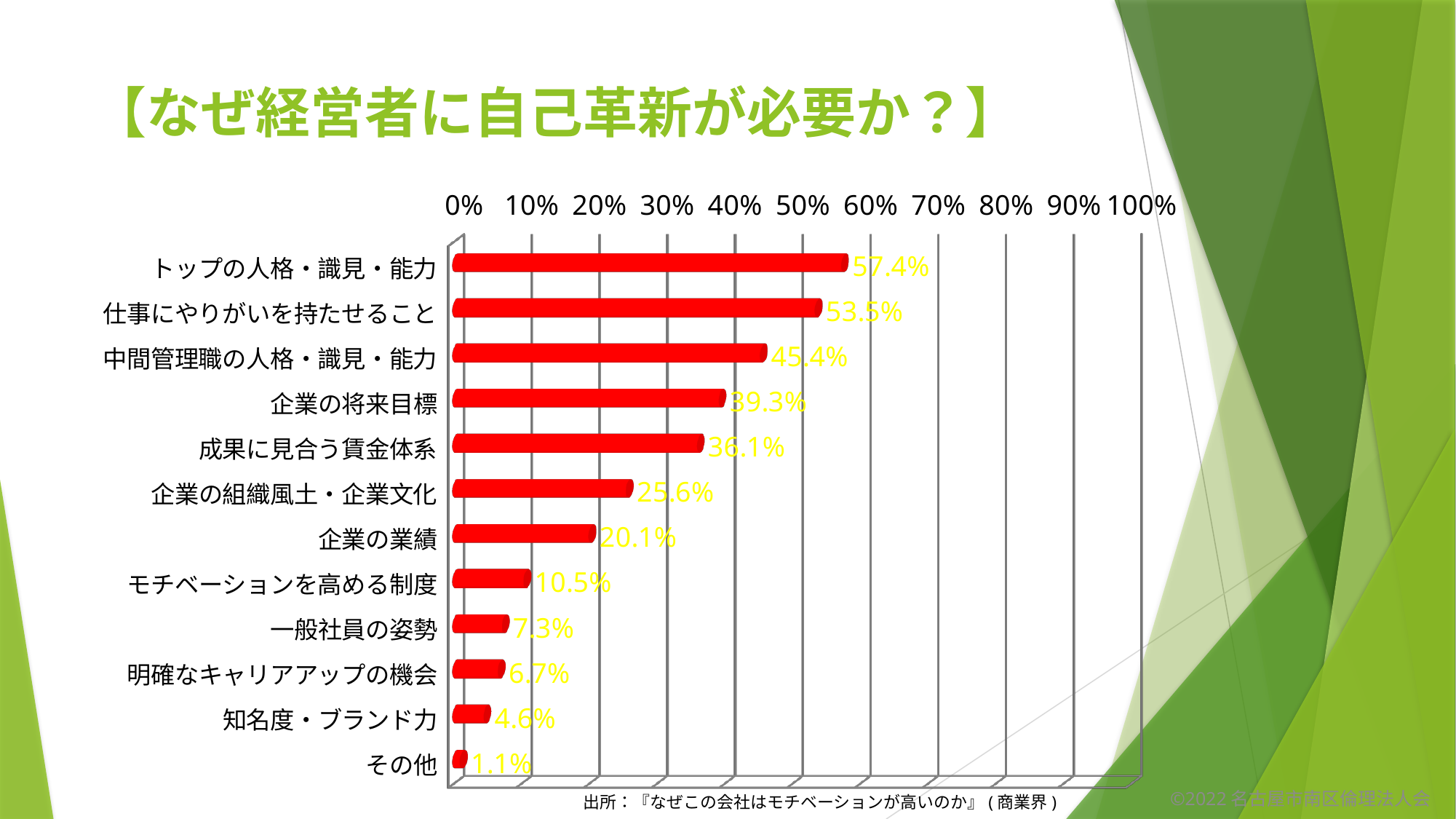
How many categories are shown in the chart? 12 Which is larger, 成果に見合う賃金体系 or 企業の組織風土・企業文化? 成果に見合う賃金体系 What is the value for トップの人格・識見・能力? 57.4% What is the difference between 仕事にやりがいを持たせること and 中間管理職の人格・識見・能力? 8.1% Which category has the highest value? トップの人格・識見・能力 Is the value for 企業の業績 greater or less than 30%? less What colour are the bars in the chart? red Which category has the lowest value? その他 What is the value for 企業の将来目標? 39.3% What is the difference between 一般社員の姿勢 and 明確なキャリアアップの機会? 0.6% What kind of chart is shown on the slide? bar chart What is the value for モチベーションを高める制度? 10.5%